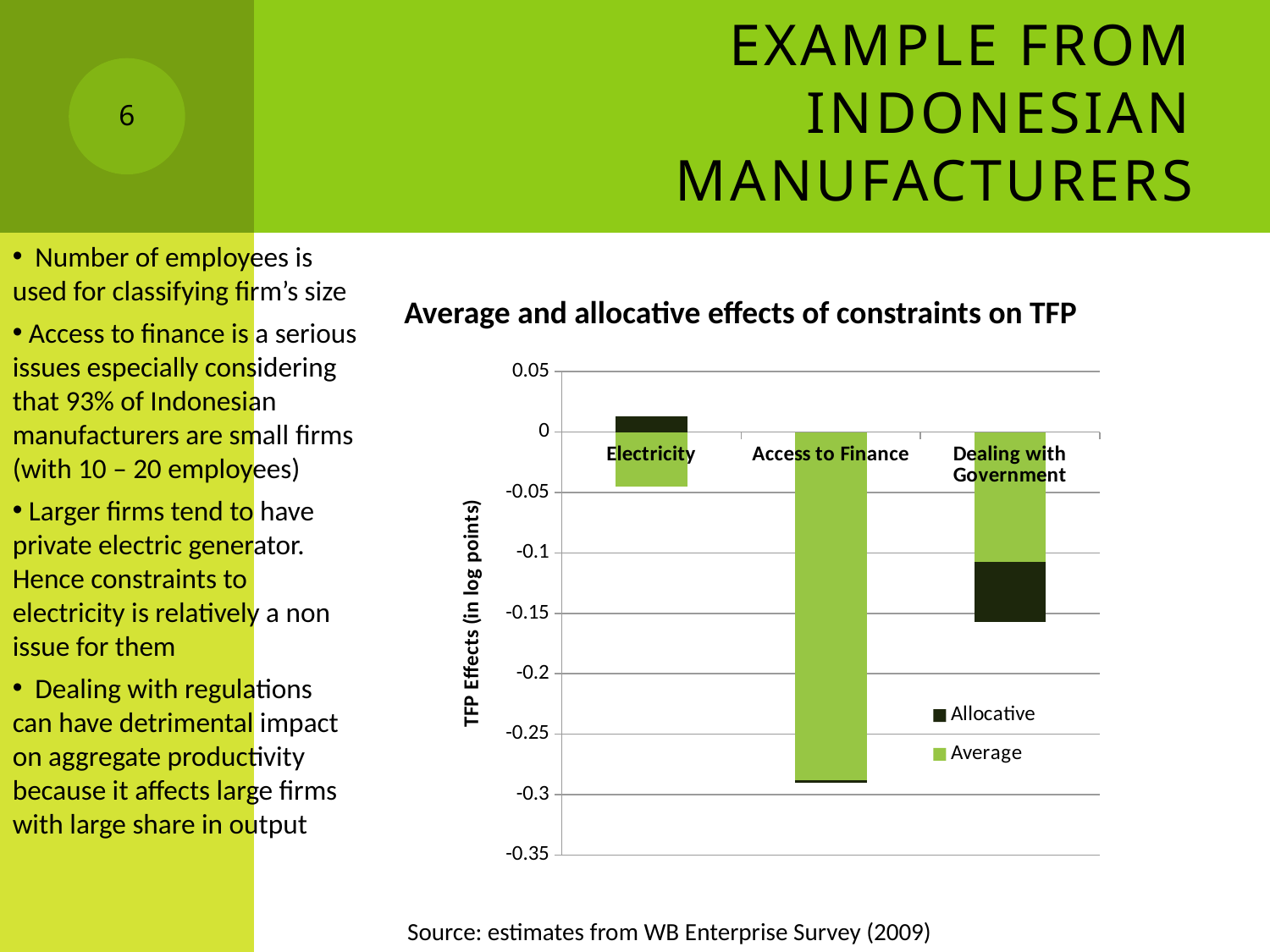
What is the title of the chart? Average and allocative effects of constraints on TFP Is the Average value for Electricity greater or less than -0.1? greater Which series is shown in the dark colour in the chart? Allocative How many categories are shown on the x axis of the chart? 3 Is the Average value for Dealing with Government greater or less than -0.05? less What kind of chart is shown on the slide? bar chart Is the Average value for Access to Finance greater or less than -0.25? less How many series does the chart's legend list? 2 Which category has the larger negative Allocative effect, Electricity or Dealing with Government? Dealing with Government Which category has the largest negative Average effect on TFP? Access to Finance Which category has the larger negative Average effect, Electricity or Access to Finance? Access to Finance